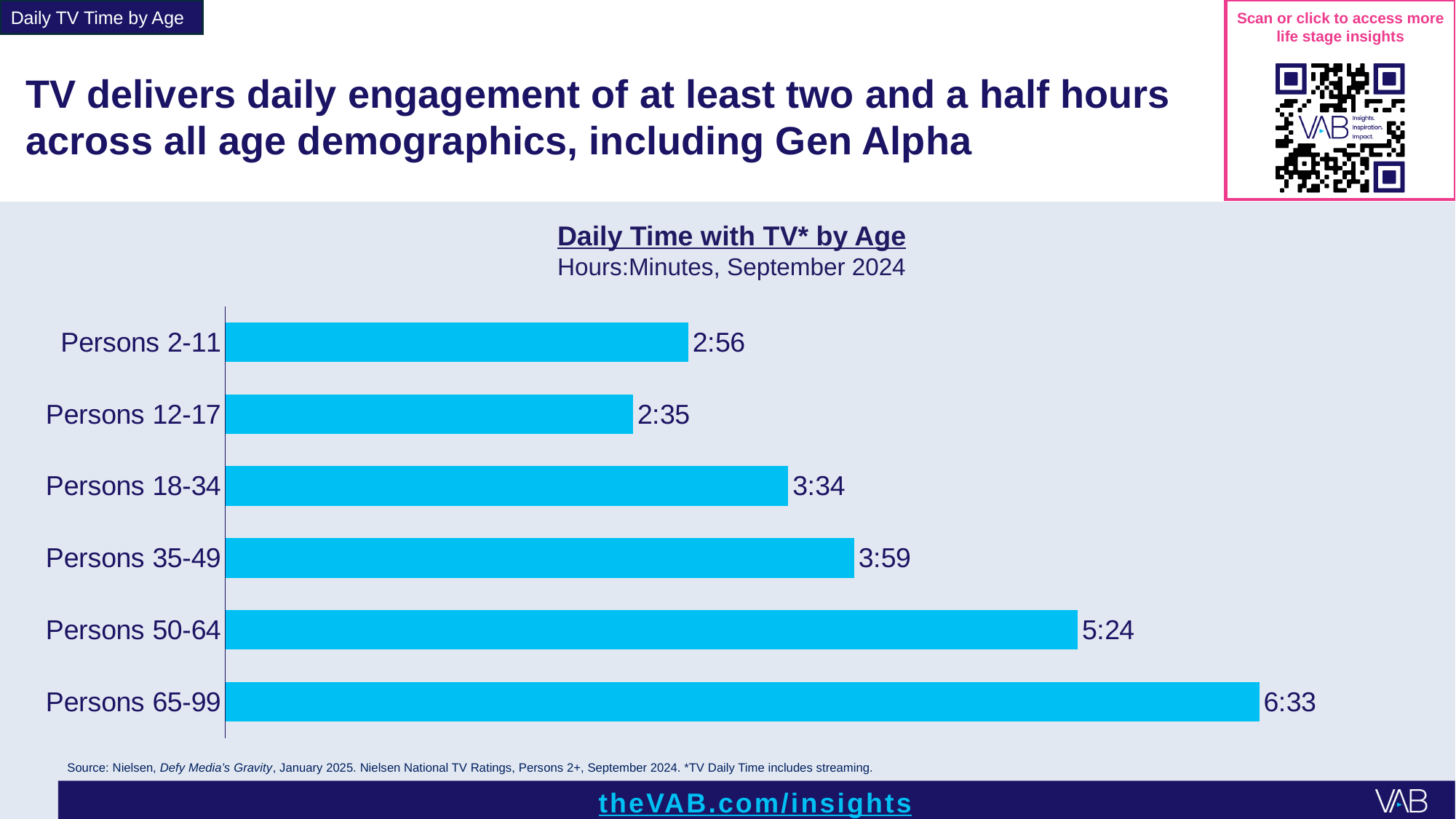
What is the daily time with TV for Persons 50-64? 5:24 Which has a higher daily time with TV, Persons 2-11 or Persons 18-34? Persons 18-34 What is the daily time with TV for Persons 18-34? 3:34 What is the daily time with TV for Persons 12-17? 2:35 Which age group has the lowest daily time with TV? Persons 12-17 How many age groups are shown in the chart? 6 What is the daily time with TV for Persons 2-11? 2:56 What is the daily time with TV for Persons 35-49? 3:59 What is the daily time with TV for Persons 65-99? 6:33 What is the title of the chart? Daily Time with TV* by Age Which age group has the highest daily time with TV? Persons 65-99 What kind of chart is used to show daily time with TV by age? Bar chart